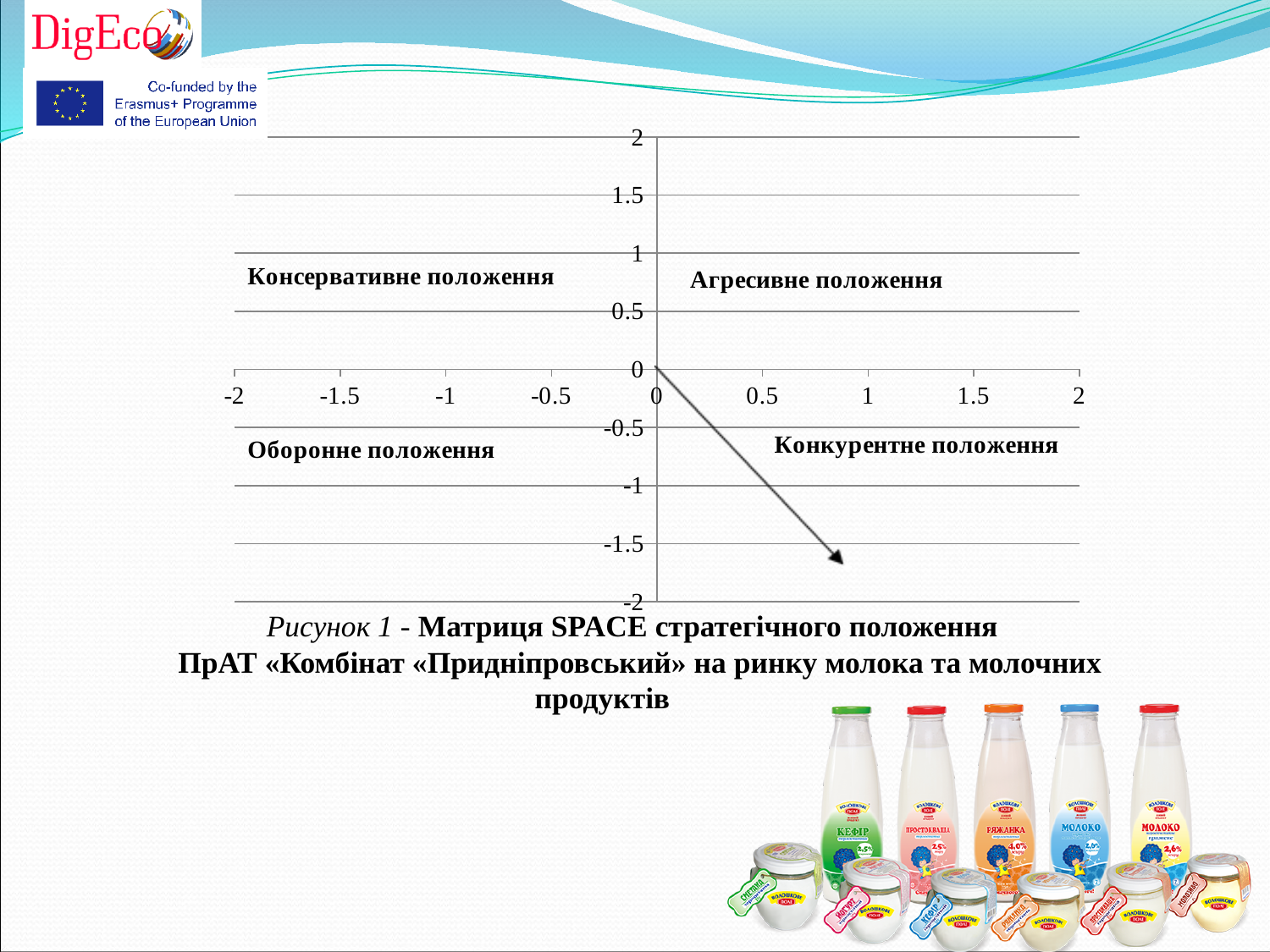
Is the y-coordinate of the arrow's endpoint greater or less than -1? less Which quadrant label is in the lower-right quadrant, where the arrow points? Конкурентне положення How many quadrant labels (strategic positions) are shown on the chart? 4 Is the y-coordinate of the arrow's endpoint greater or less than -2? greater What is the maximum value shown on the horizontal axis? 2 Is the x-coordinate of the arrow's endpoint greater or less than 1.5? less What kind of chart is shown on the slide? scatter chart What is the minimum value shown on the vertical axis? -2 Which quadrant label is in the upper-left quadrant of the chart? Консервативне положення What is the interval between consecutive tick marks on the vertical axis? 0.5